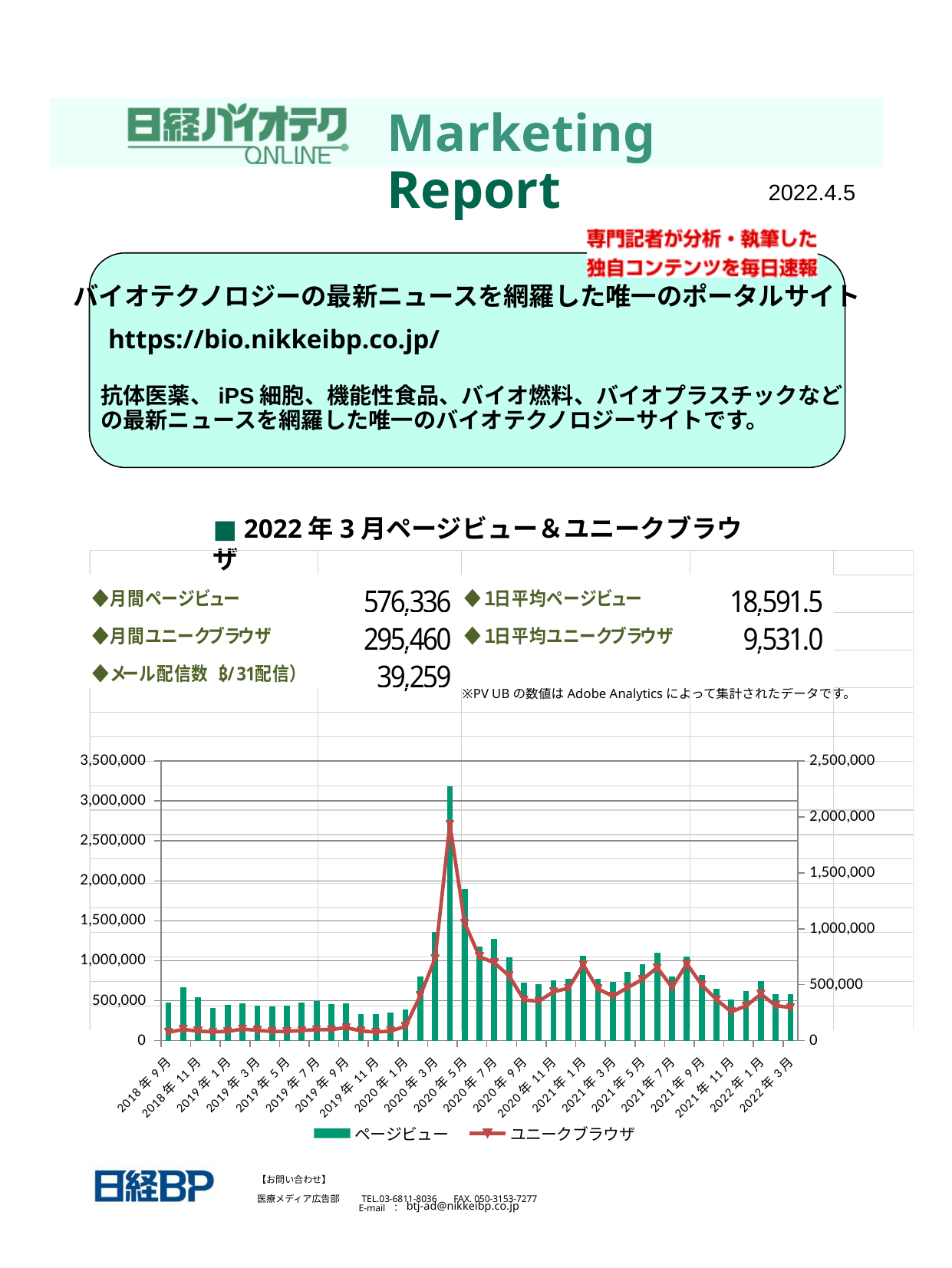
Is the ユニークブラウザ value for 2021年1月 greater or less than 500,000 on the right axis? greater Which has the larger ページビュー value, 2018年11月 or 2019年11月? 2018年11月 Is the ユニークブラウザ value for 2019年5月 greater or less than 500,000 on the right axis? less Is the highest ページビュー bar in the chart greater or less than 3,000,000? greater How many monthly data points are plotted in the chart, from 2018年9月 to 2022年3月? 43 Do the ページビュー values rise or fall from 2020年5月 to 2020年9月? fall What kind of chart is shown on the slide? A combined bar and line chart How many series does the chart legend list? 2 Which series is drawn as bars in the chart? ページビュー What is the maximum value shown on the left vertical axis of the chart? 3,500,000